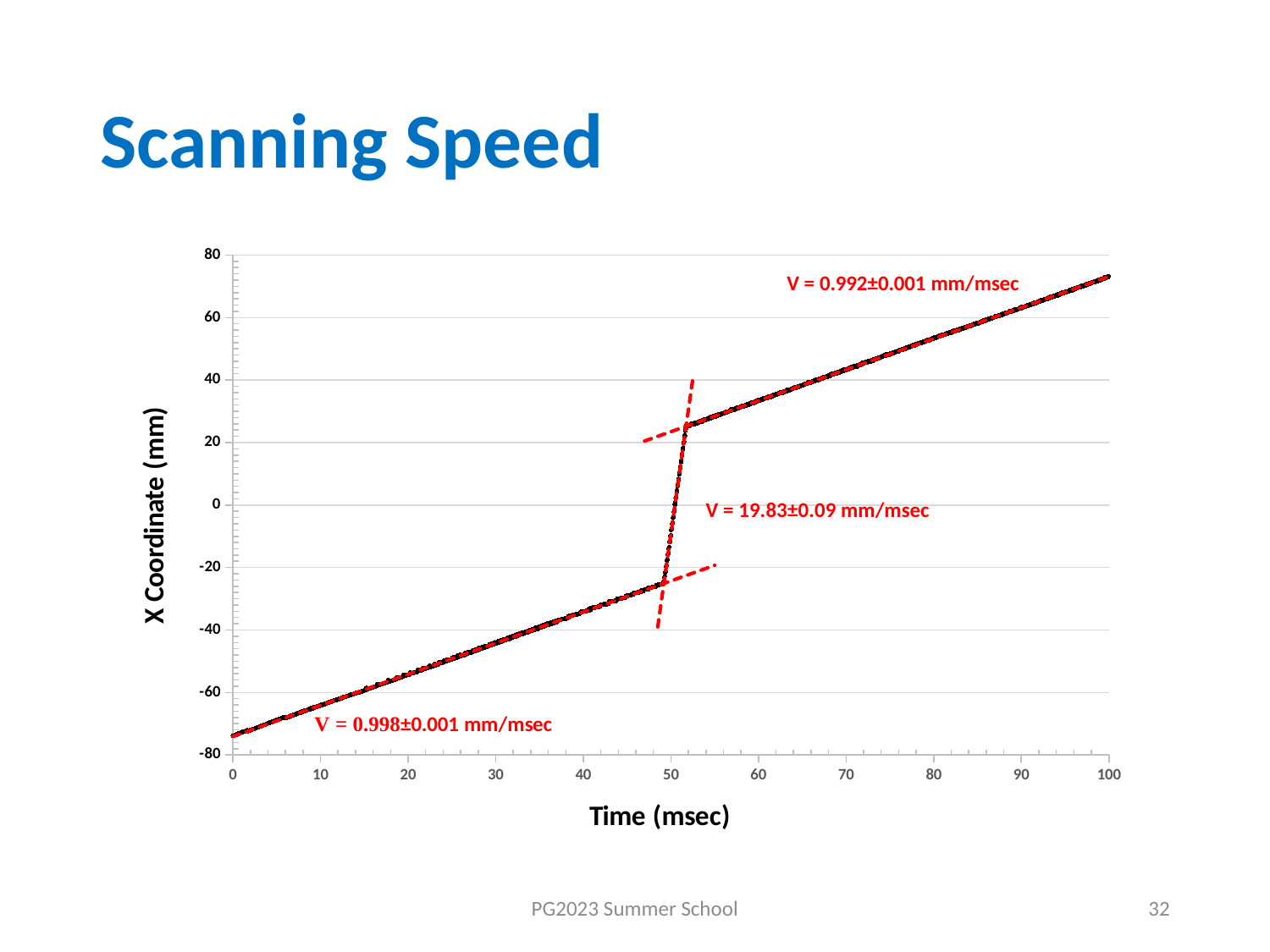
What is the title of the slide containing the chart? Scanning Speed Is the X Coordinate at Time 20 msec greater or less than -40 mm? less What is the label of the x axis? Time (msec) Is the X Coordinate at Time 80 msec greater or less than 40 mm? greater Which printed velocity is larger, the one for the first segment (0.998 mm/msec) or the one for the middle jump (19.83 mm/msec)? The middle jump (19.83 mm/msec) Is the X Coordinate at Time 0 msec greater or less than -60 mm? less Does the X Coordinate rise or fall as Time increases along the x axis? Rise What fitted velocity is printed for the steep middle jump of the curve? V = 19.83±0.09 mm/msec What kind of chart is shown on the slide? Scatter (line) chart What fitted velocity is printed for the first (lower-left) segment of the curve? V = 0.998±0.001 mm/msec What fitted velocity is printed for the last (upper-right) segment of the curve? V = 0.992±0.001 mm/msec